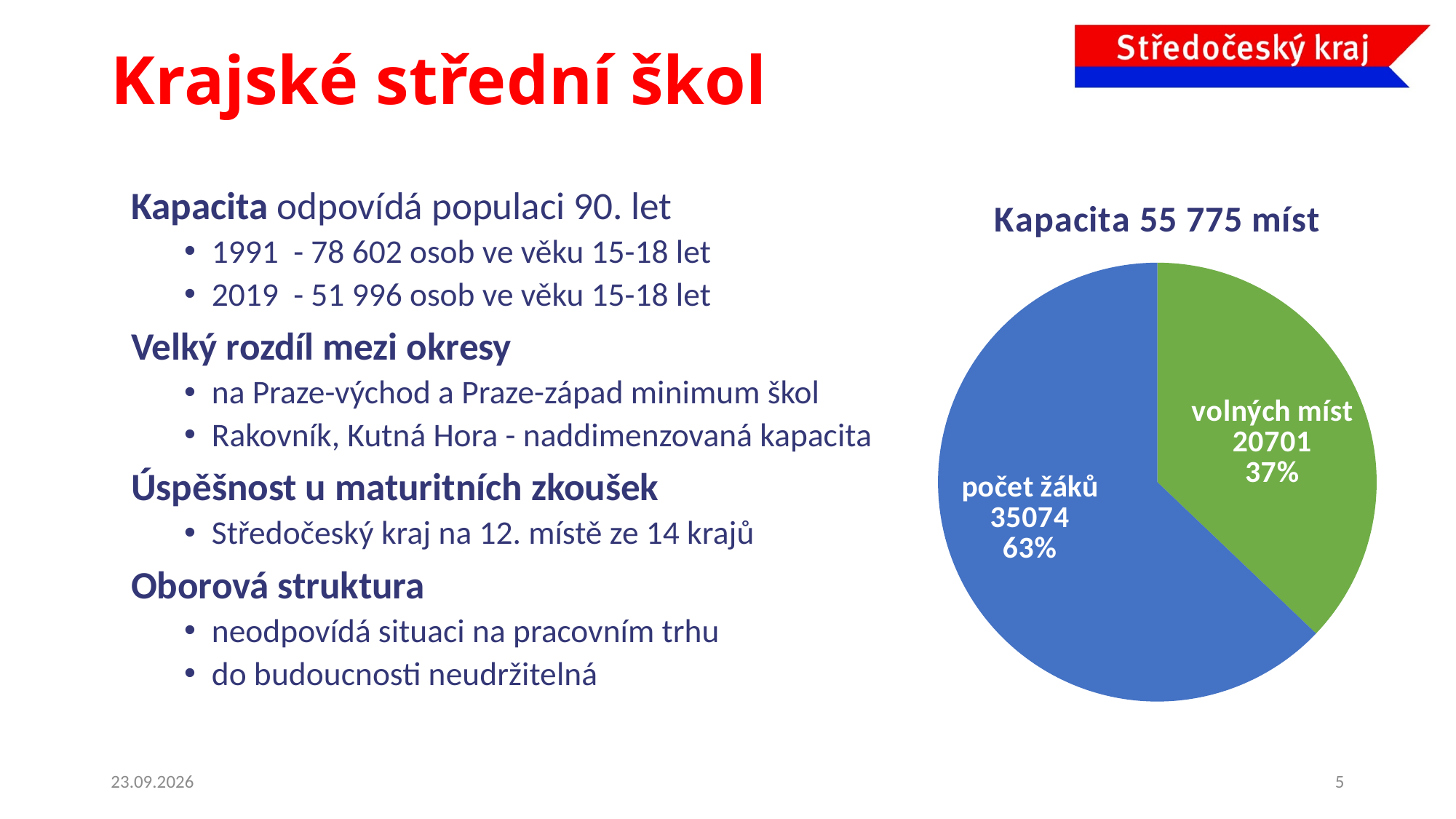
How many slices does the pie chart have? 2 Which slice is the smallest? volných míst What share of the pie does počet žáků represent? 63% Which slice is the largest? počet žáků What share of the pie does volných míst represent? 37% What is the value for počet žáků? 35074 What is the title of the chart? Kapacita 55 775 míst What is the value for volných míst? 20701 What colour is the slice for volných míst? green What kind of chart is shown on the slide? pie chart What is the difference between počet žáků and volných míst? 14373 Which is larger, počet žáků or volných míst? počet žáků